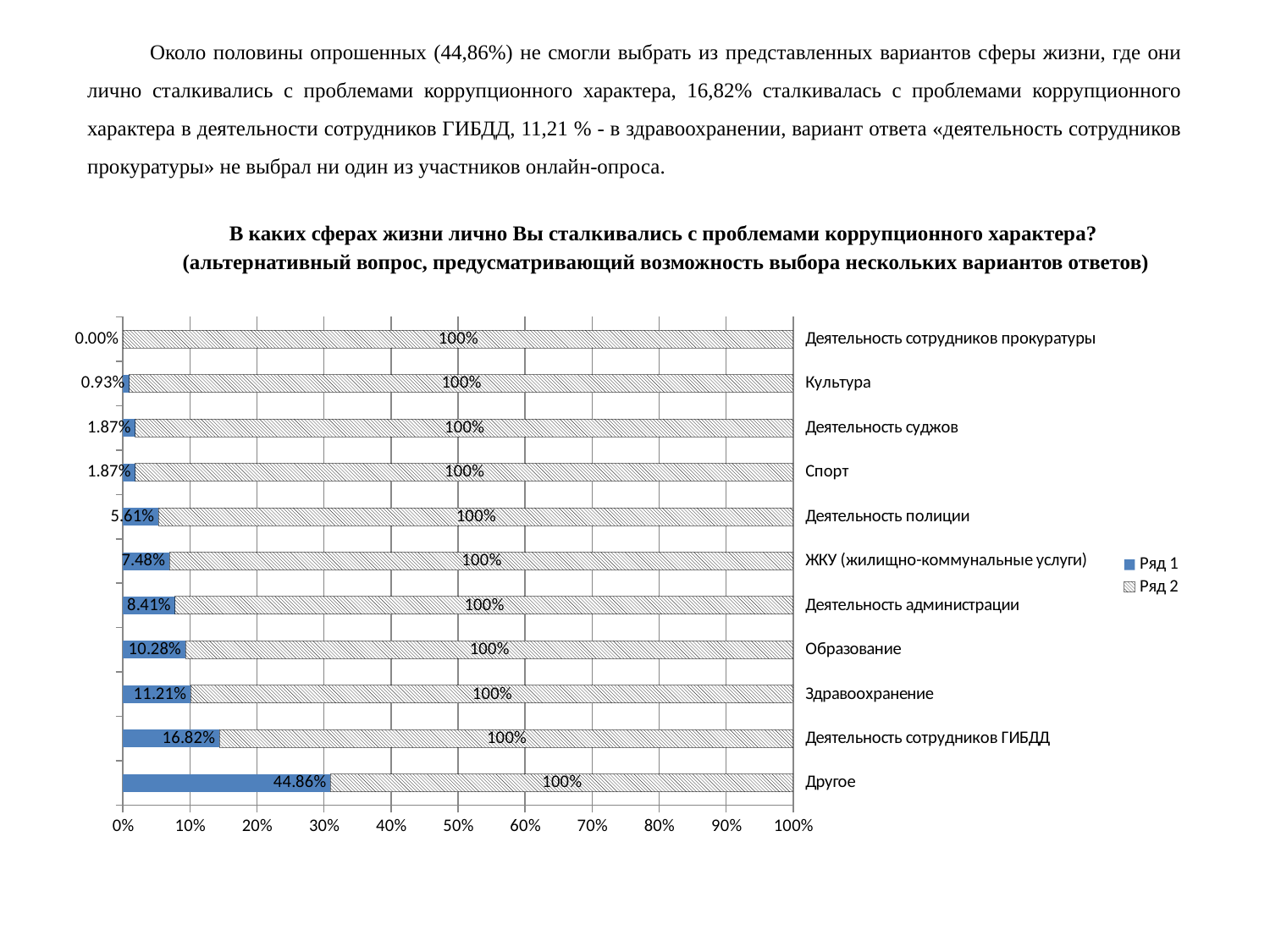
What is the Ряд 1 value for Культура? 0.93% How many series does the legend list? 2 What is the difference between the Ряд 1 values for Другое and Деятельность сотрудников ГИБДД? 28.04% What is the Ряд 2 value shown for Спорт? 100% What is the Ряд 1 value for Здравоохранение? 11.21% What is the Ряд 1 value for Образование? 10.28% How many categories are shown on the chart? 11 Which has a larger Ряд 1 value, Деятельность полиции or Деятельность администрации? Деятельность администрации Which category has the lowest Ряд 1 value? Деятельность сотрудников прокуратуры What is the Ряд 1 value for Деятельность сотрудников ГИБДД? 16.82% Which category has the highest Ряд 1 value? Другое What kind of chart is shown on the slide? Bar chart